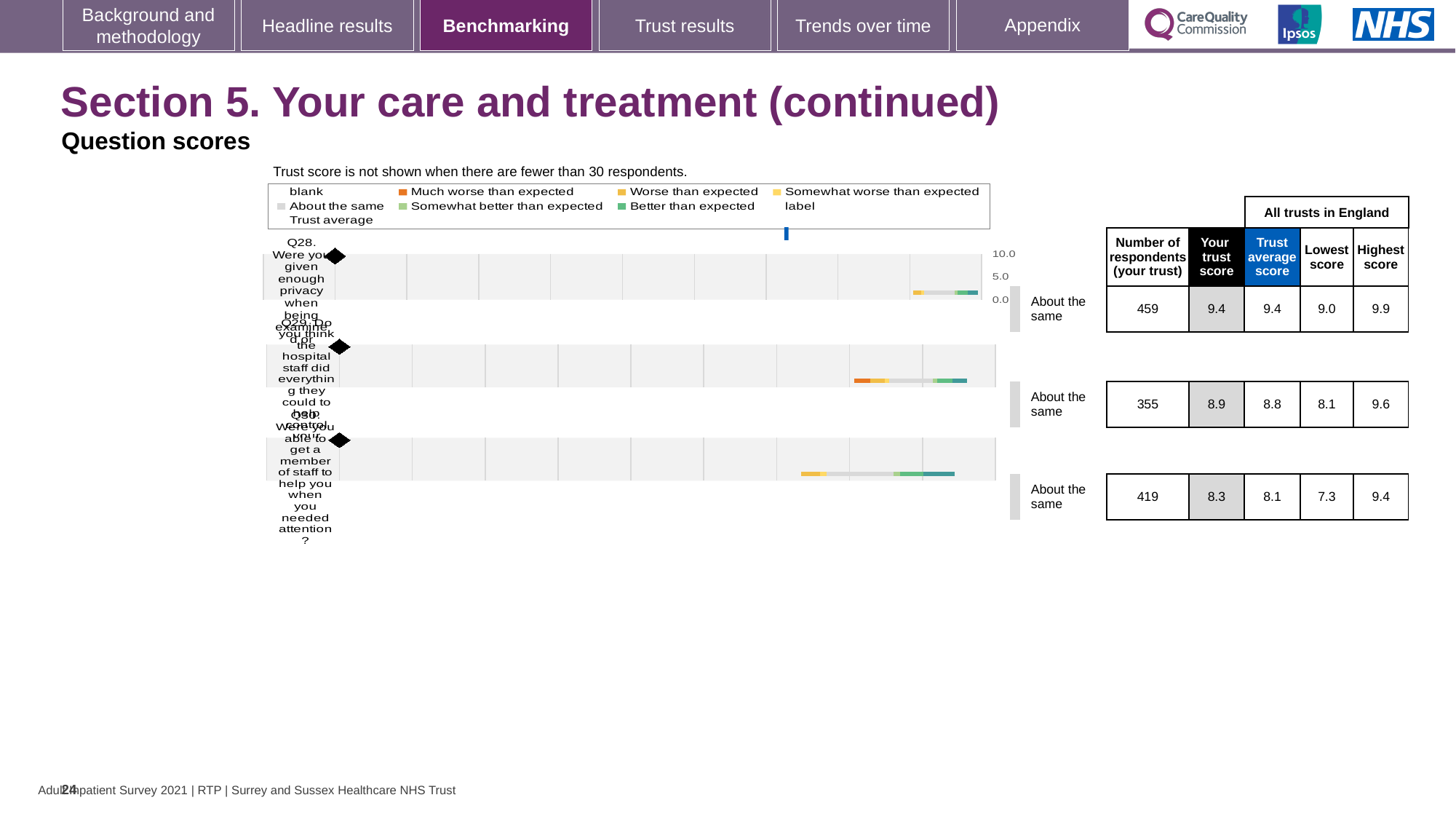
What kind of chart is used to show the question scores on this slide? bar chart How many questions (Q28, Q29, Q30) are plotted in the benchmarking charts on this slide? 3 What is the trust score for Q29 (Do you think the hospital staff did everything they could to help control your pain?) shown in the table? 8.9 What benchmark category is shown next to each of the three question charts? About the same Which of the three questions has the lowest trust score? Q30 Which of the three questions has the highest trust score? Q28 What is the highest value shown on the score axis of the benchmarking chart? 10.0 Which is larger: the trust score for Q29 or the trust average score for Q29? the trust score for Q29 (8.9) Is the trust score for Q29 greater or less than 5.0 on the chart axis? greater What is the trust score for Q28 (Were you given enough privacy when being examined or treated?) shown in the table? 9.4 What is the difference between the trust score for Q28 and the trust score for Q30? 1.1 What is the trust score for Q30 (Were you able to get a member of staff to help you when you needed attention?) shown in the table? 8.3